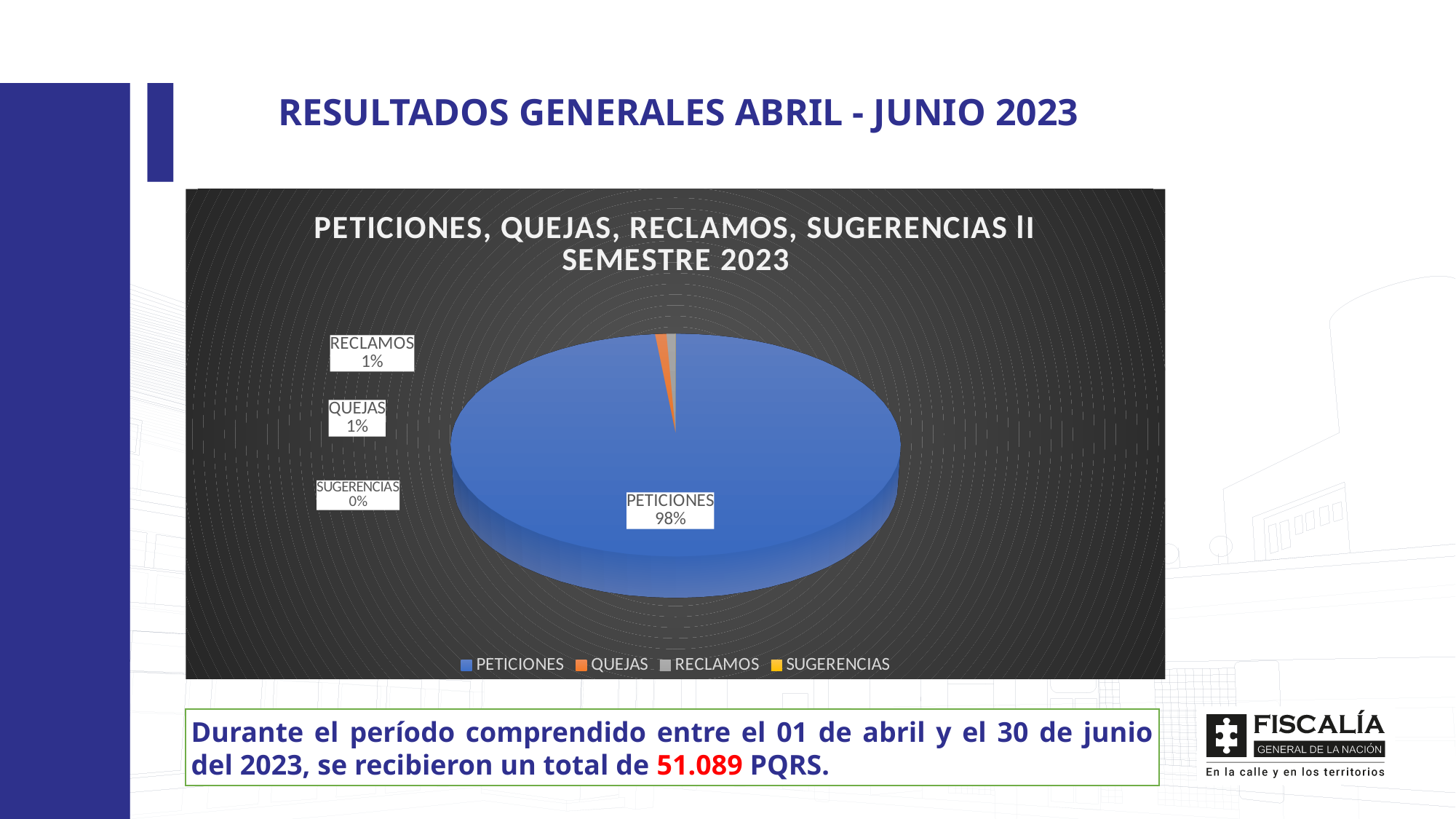
Which category has the smallest slice of the pie? SUGERENCIAS Which is larger, the share for PETICIONES or the share for RECLAMOS? PETICIONES Which category has the largest slice of the pie? PETICIONES What colour is the PETICIONES slice in the pie chart? Blue What share of the pie does SUGERENCIAS represent? 0% What kind of chart is shown on the slide? Pie chart What share of the pie does RECLAMOS represent? 1% What share of the pie does PETICIONES represent? 98% What is the difference in percentage points between PETICIONES and QUEJAS? 97 What is the title of the chart? PETICIONES, QUEJAS, RECLAMOS, SUGERENCIAS II SEMESTRE 2023 How many categories does the legend list? 4